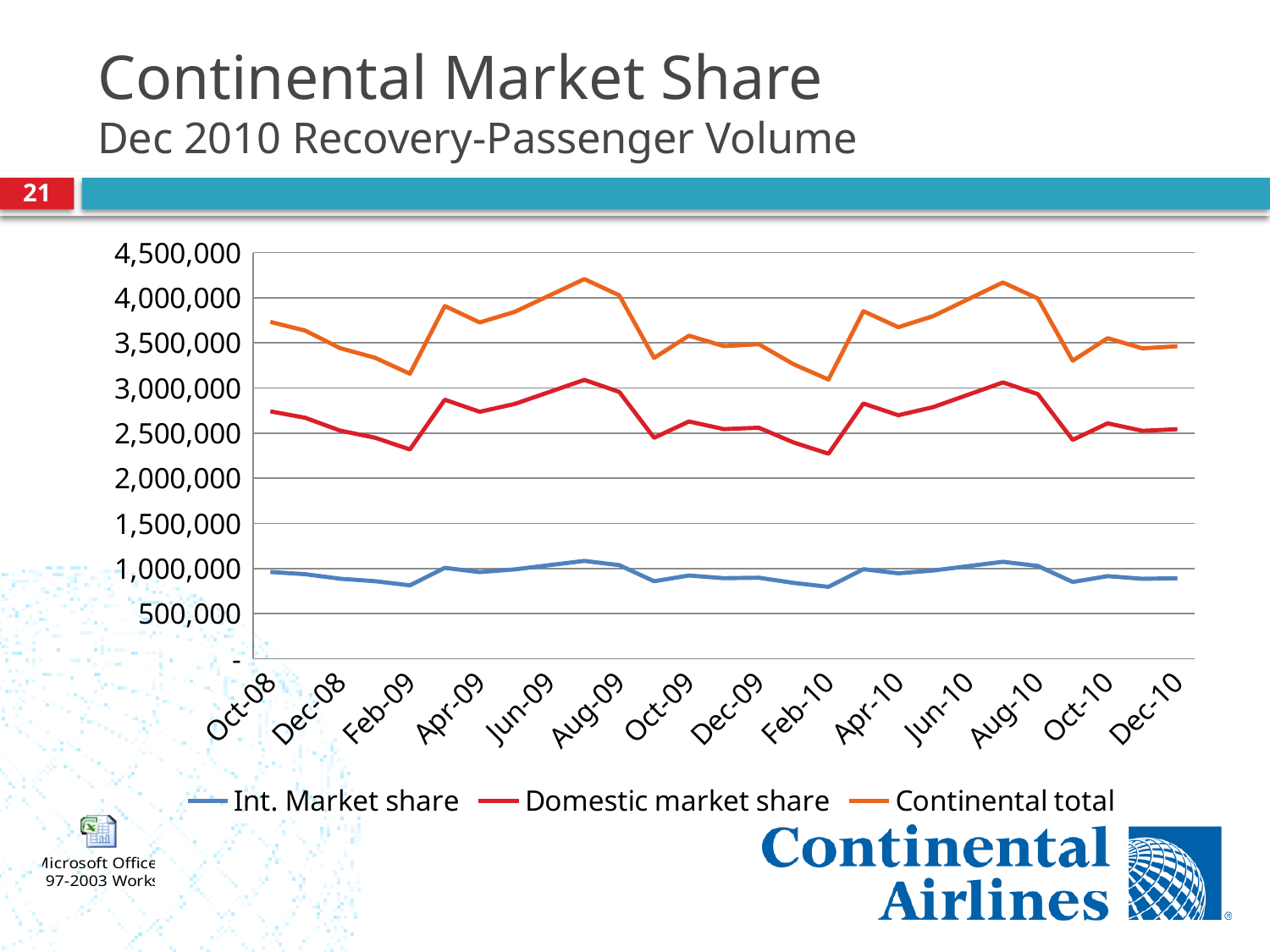
How many series does the legend list? 3 Which series has the highest values across the whole period? Continental total Is the value for Continental total at Feb-10 greater or less than 3,500,000? less What kind of chart is shown on the slide? line chart What colour is the Continental total line? orange Is the value for Domestic market share at Feb-10 greater or less than 2,500,000? less Is the value for Int. Market share at Feb-09 greater or less than 1,000,000? less How many month labels are shown on the x axis? 14 Does the Continental total line rise or fall from Feb-09 to Aug-09? rise At Oct-08, is Domestic market share higher or lower than Int. Market share? higher